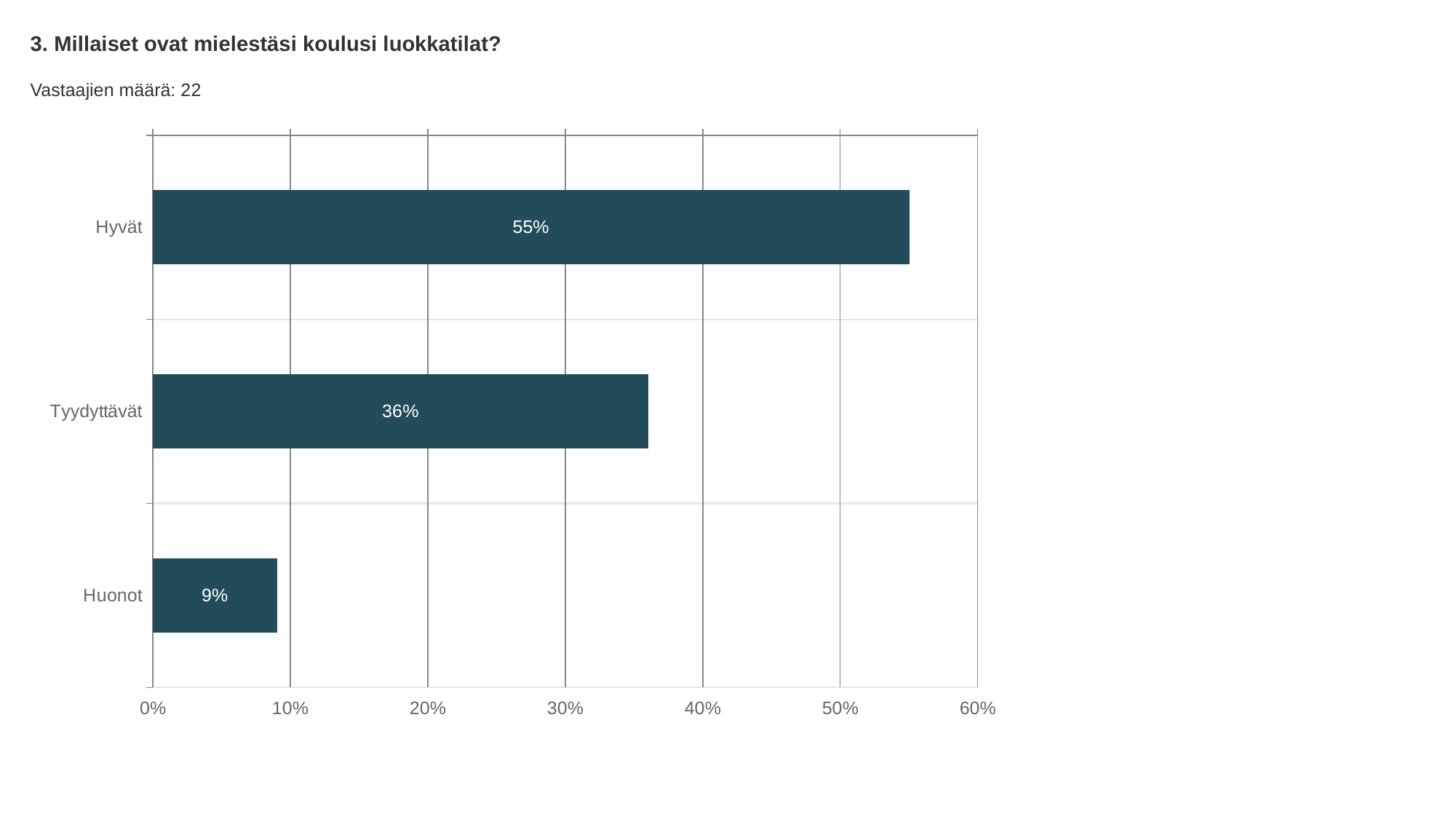
How many categories are shown in the chart? 3 Which category has the lowest value? Huonot What kind of chart is shown on the slide? bar chart What is the value for Huonot? 9% Is the value for Hyvät greater or less than 50%? greater Which category has the highest value? Hyvät How many respondents (Vastaajien määrä) are stated on the slide? 22 What is the difference between the values for Hyvät and Tyydyttävät? 19% Which is larger, the value for Tyydyttävät or the value for Huonot? Tyydyttävät What is the difference between the values for Tyydyttävät and Huonot? 27% What is the value for Hyvät? 55% What is the value for Tyydyttävät? 36%